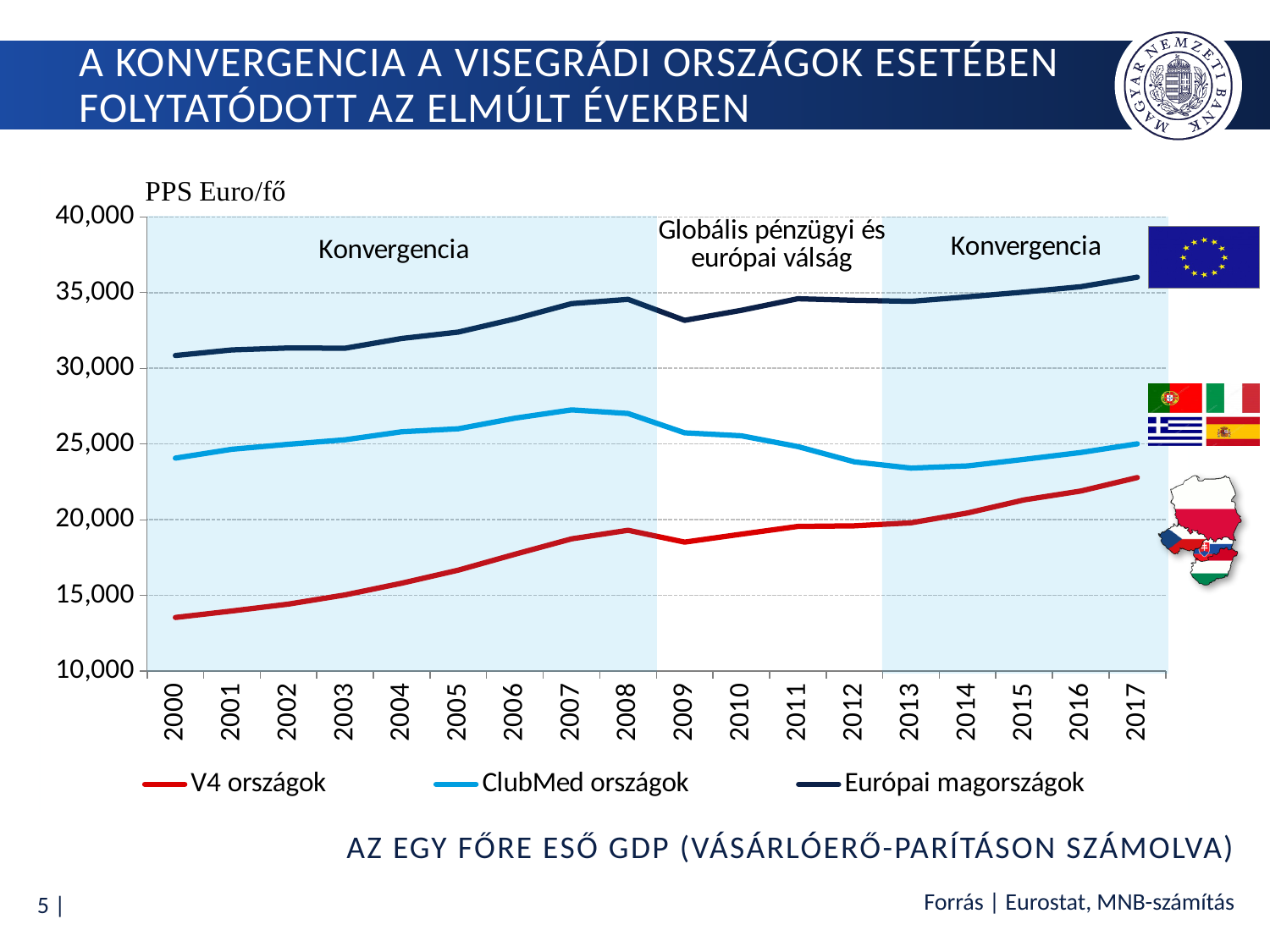
What kind of chart is shown on the slide? line chart Do the values for ClubMed országok rise or fall between 2008 and 2013? fall Is the value for Európai magországok in 2017 greater or less than 35,000? greater In 2010, which is larger: the value for ClubMed országok or for V4 országok? ClubMed országok Which series has the highest values throughout the period? Európai magországok How many years are shown on the x axis? 18 How many series does the legend list? 3 Is the value for V4 országok in 2017 greater or less than 20,000? greater Is the value for ClubMed országok in 2013 greater or less than 25,000? less What unit is shown above the y axis of the chart? PPS Euro/fő Which series has the lowest values throughout the period? V4 országok